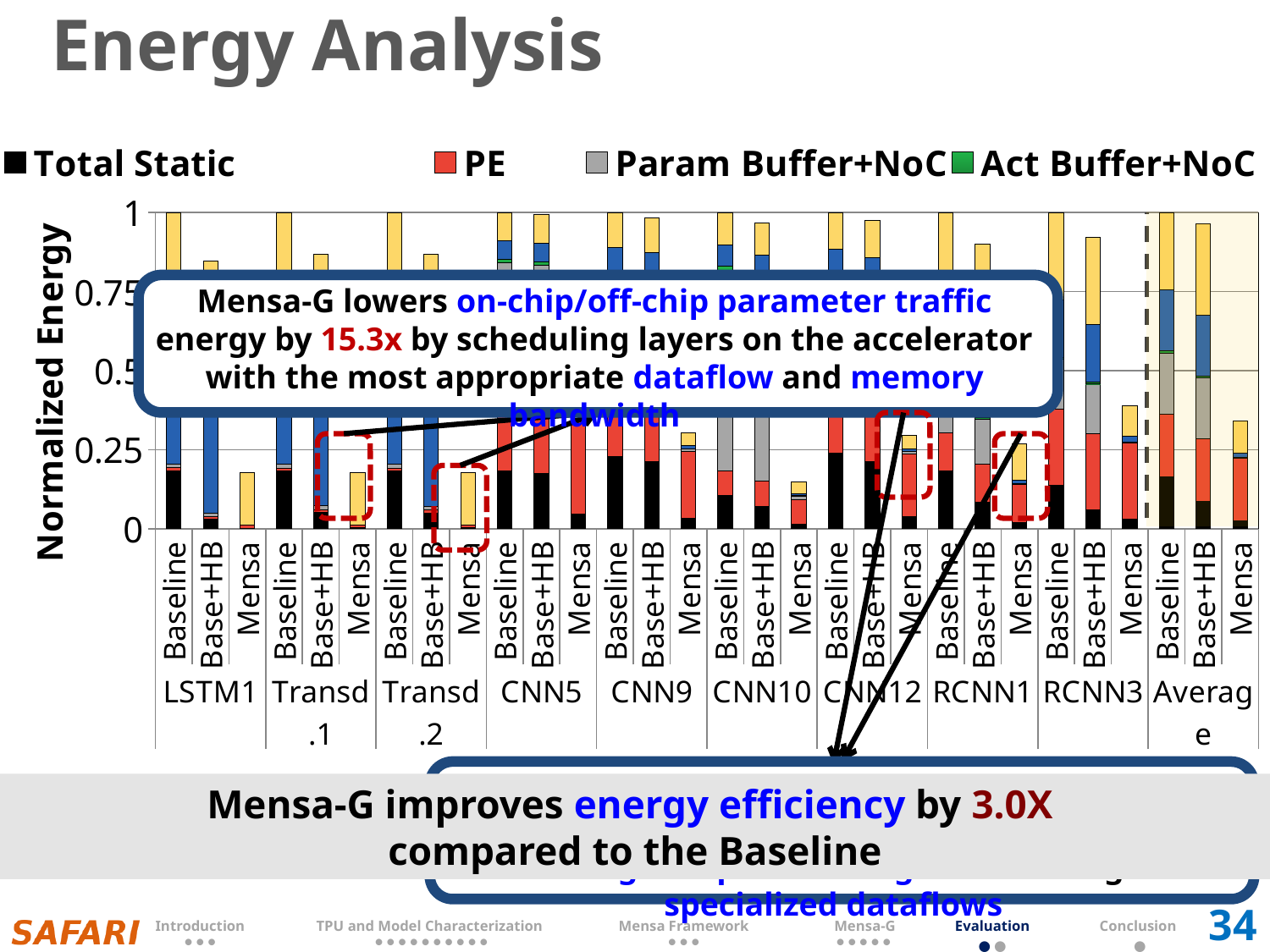
What is the total normalized energy of the Baseline bar for LSTM1? 1 What kind of chart is shown on the slide? Stacked bar chart Is the total normalized energy of the Mensa bar in the Average group greater or less than 0.5? less Is the total normalized energy of the Base+HB bar for LSTM1 greater or less than 0.75? greater How many bars are plotted within each workload group (e.g., LSTM1)? 3 Within the Average group, which bar has the lowest total normalized energy? Mensa Is the total normalized energy of the Mensa bar for LSTM1 greater or less than 0.25? less How many series does the visible legend list? 4 What is the label of the y axis? Normalized Energy How many workload groups are shown along the x axis of the chart? 10 Within the Average group, which bar has the highest total normalized energy? Baseline